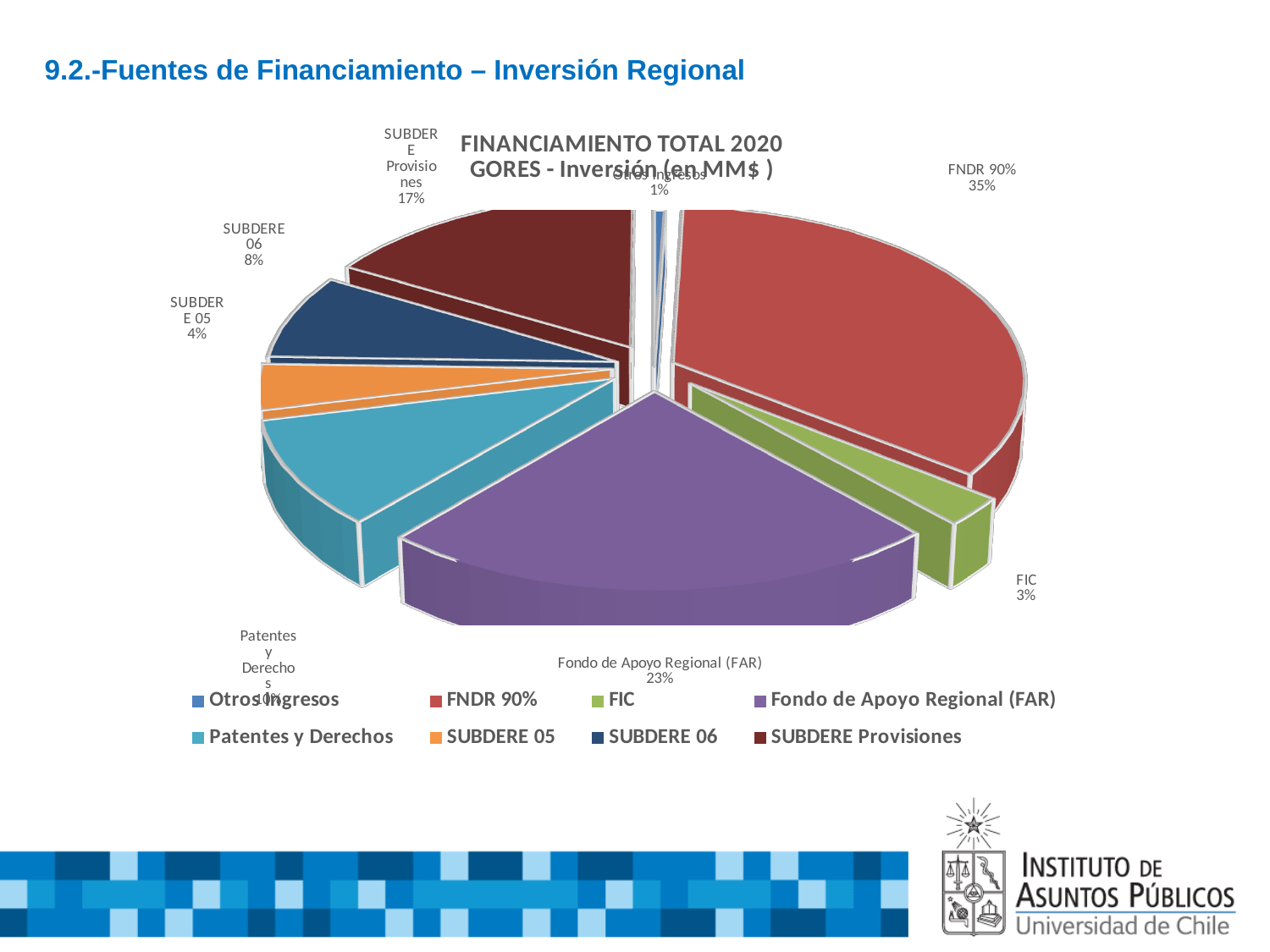
What kind of chart is shown on the slide? Pie chart What percentage is shown for SUBDERE 05? 4% Which category has the smallest share of the pie? Otros Ingresos What percentage is shown for FIC? 3% What percentage is shown for SUBDERE Provisiones? 17% Which is larger, the share for Fondo de Apoyo Regional (FAR) or the share for SUBDERE Provisiones? Fondo de Apoyo Regional (FAR) Which category has the largest share of the pie? FNDR 90% What is the title of the chart? FINANCIAMIENTO TOTAL 2020 GORES - Inversión (en MM$ ) What share of the pie does Fondo de Apoyo Regional (FAR) represent? 23% How many categories does the legend list? 8 By how many percentage points does the FNDR 90% share exceed the Fondo de Apoyo Regional (FAR) share? 12 percentage points What percentage is shown for SUBDERE 06? 8%